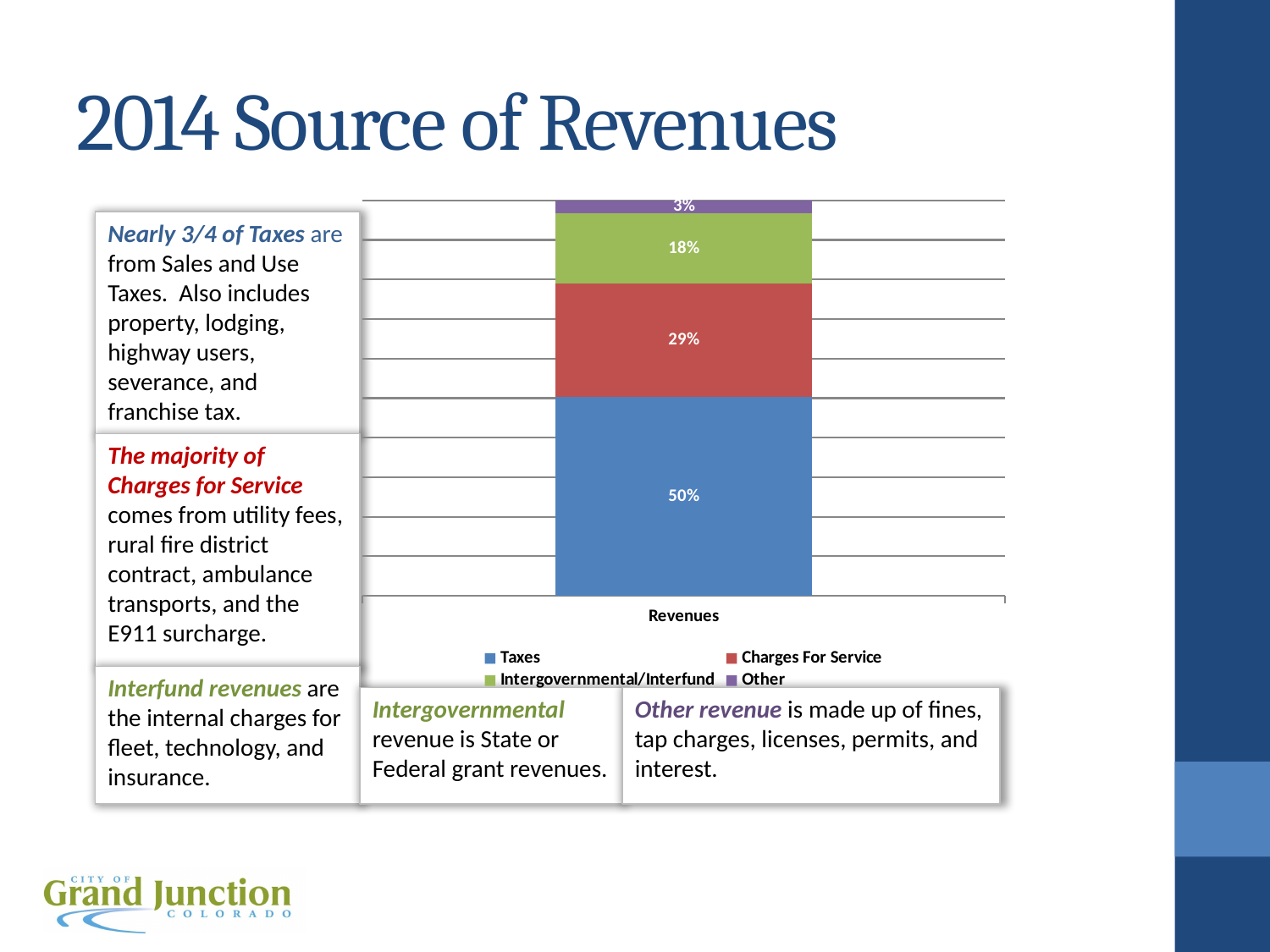
What percentage of revenues comes from Intergovernmental/Interfund? 18% What percentage of revenues comes from Taxes? 50% What percentage of revenues comes from Other? 3% Which is larger, the Charges For Service share or the Intergovernmental/Interfund share? Charges For Service How many series does the legend list? 4 What percentage of revenues comes from Charges For Service? 29% What colour represents Taxes in the chart? Blue Which revenue source has the smallest share? Other What is the difference between the Taxes share and the Charges For Service share? 21% What kind of chart is shown on the slide? Stacked bar chart Which revenue source has the largest share? Taxes What is the total of the stacked Revenues bar? 100%